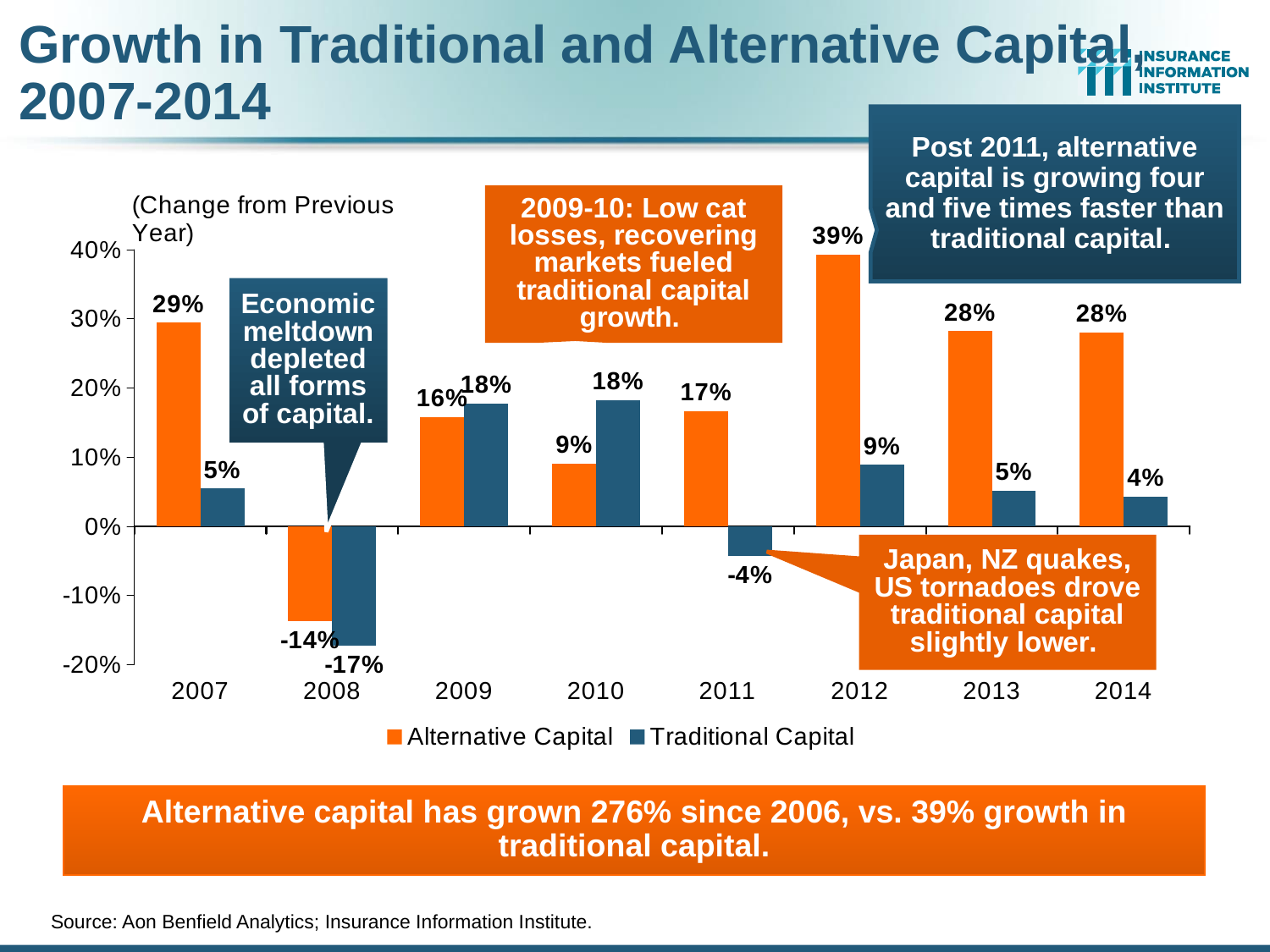
How many years are shown on the x axis? 8 What is the value for Alternative Capital in 2010? 9% In which year is Alternative Capital highest? 2012 What is the difference between Alternative Capital and Traditional Capital in 2012? 30% In which year is Traditional Capital lowest? 2008 Which colour represents Alternative Capital in the chart? Orange What is the value for Alternative Capital in 2012? 39% How many series does the legend list? 2 What is the value for Traditional Capital in 2008? -17% Which is larger in 2010, Alternative Capital or Traditional Capital? Traditional Capital What kind of chart is shown? Bar chart What is the value for Traditional Capital in 2011? -4%